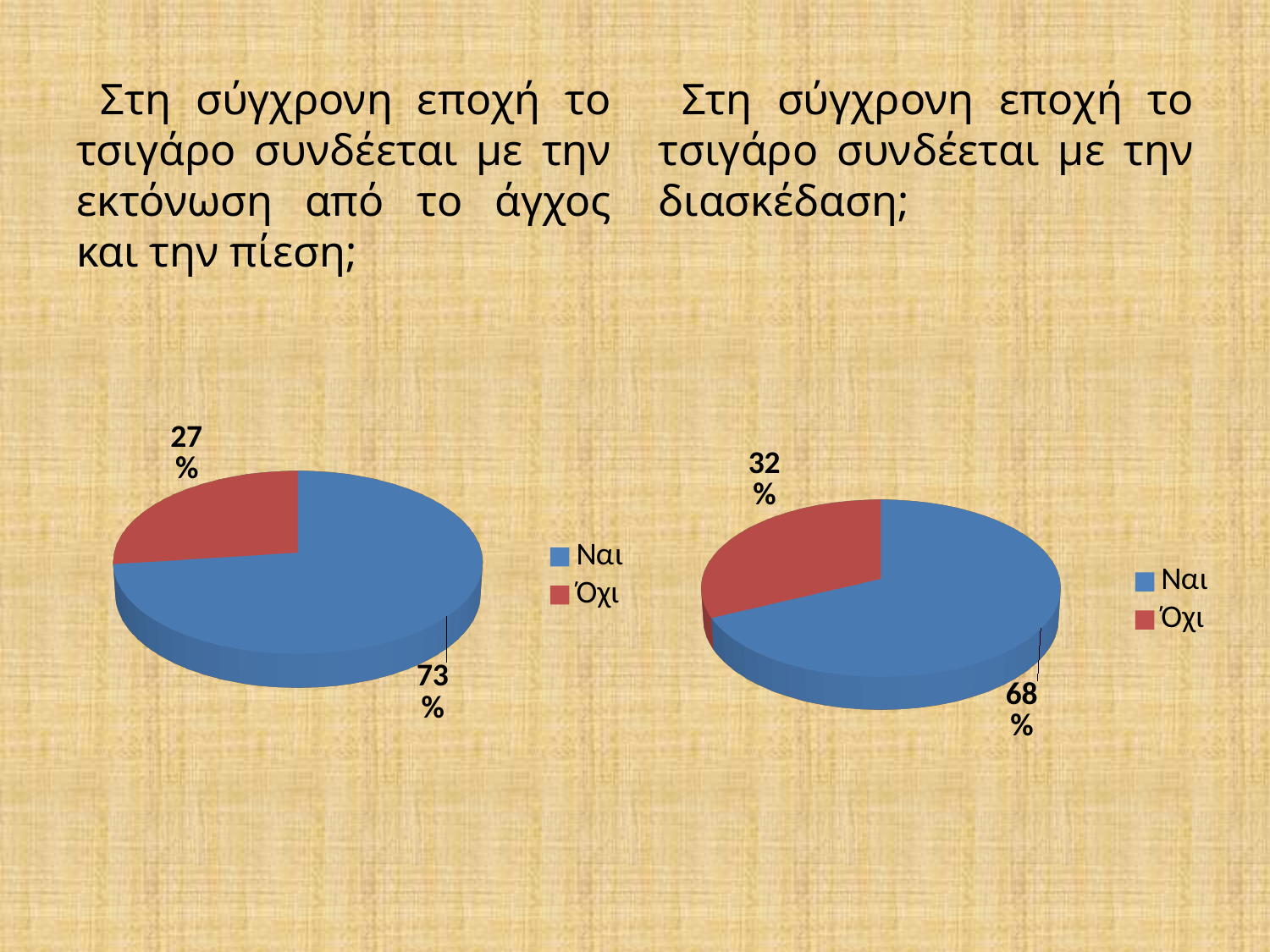
What kind of chart is the left chart? pie chart In the right pie chart, what is the difference in percentage points between Ναι and Όχι? 36 How many entries does the legend of the right pie chart list? 2 In the left pie chart, what is the difference in percentage points between Ναι and Όχι? 46 In the left pie chart, what share is labelled for Ναι? 73% In the right pie chart, which slice is the smallest? Όχι In the right pie chart, what share is labelled for Ναι? 68% Is the Ναι share larger in the left pie chart or the right pie chart? left In the right pie chart, what colour is the Όχι slice? red In the left pie chart, what share is labelled for Όχι? 27% In the right pie chart, what share is labelled for Όχι? 32% In the left pie chart, which slice is the largest? Ναι